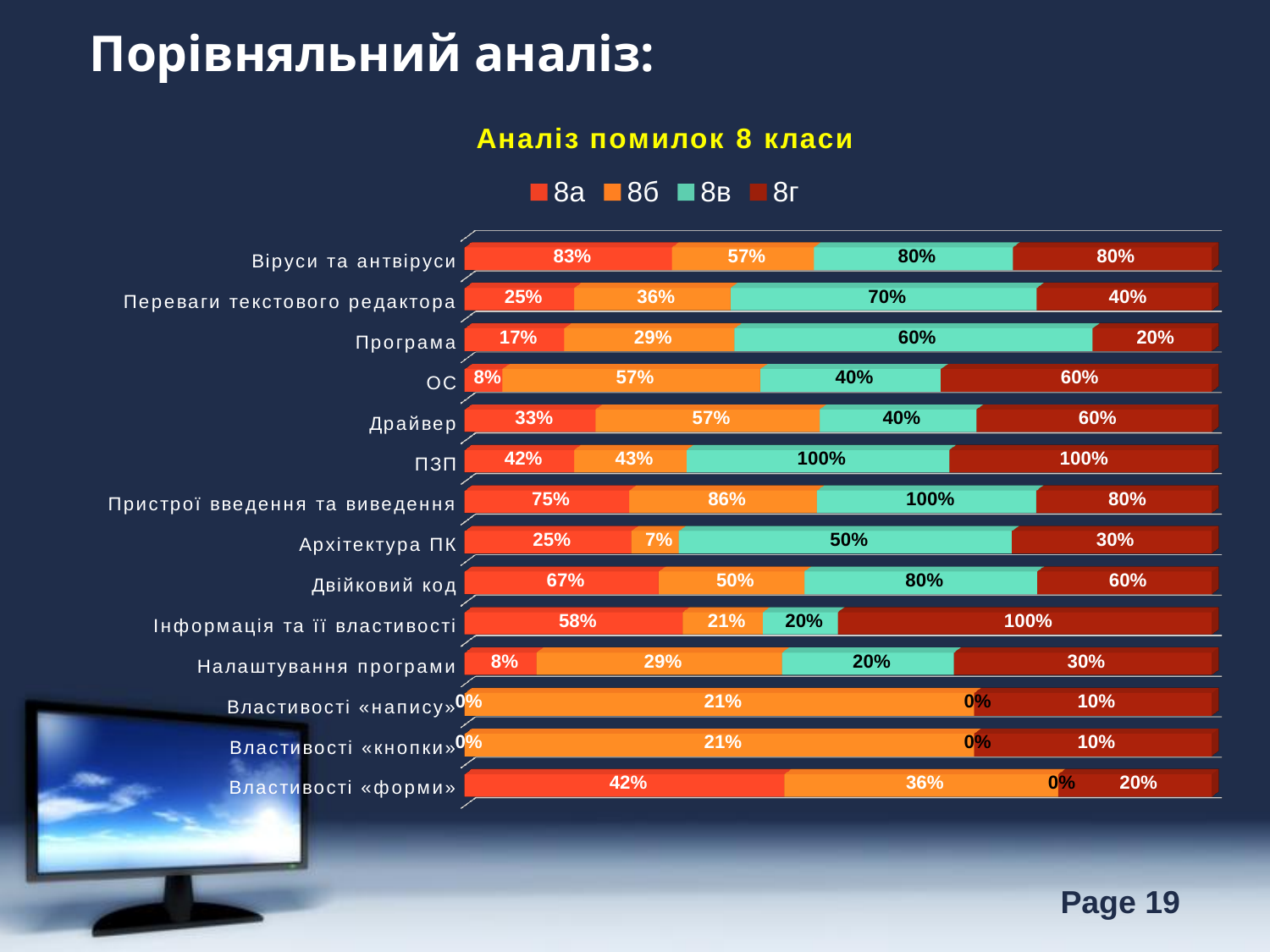
In the category "ОС", which series has the larger value, 8б or 8в? 8б What is the value for 8г in the category "Інформація та її властивості"? 100% What is the title of the chart? Аналіз помилок 8 класи How many categories are shown on the chart? 14 What type of chart is shown on the slide? stacked bar chart Which category has the lowest value for series 8б? Архітектура ПК What is the value for 8в in the category "Переваги текстового редактора"? 70% What is the difference between the 8в and 8а values in the category "Двійковий код"? 13% Which category has the highest value for series 8а? Віруси та антвіруси What is the value for 8б in the category "Архітектура ПК"? 7% What is the value for 8а in the category "Віруси та антвіруси"? 83% How many series does the chart legend list? 4